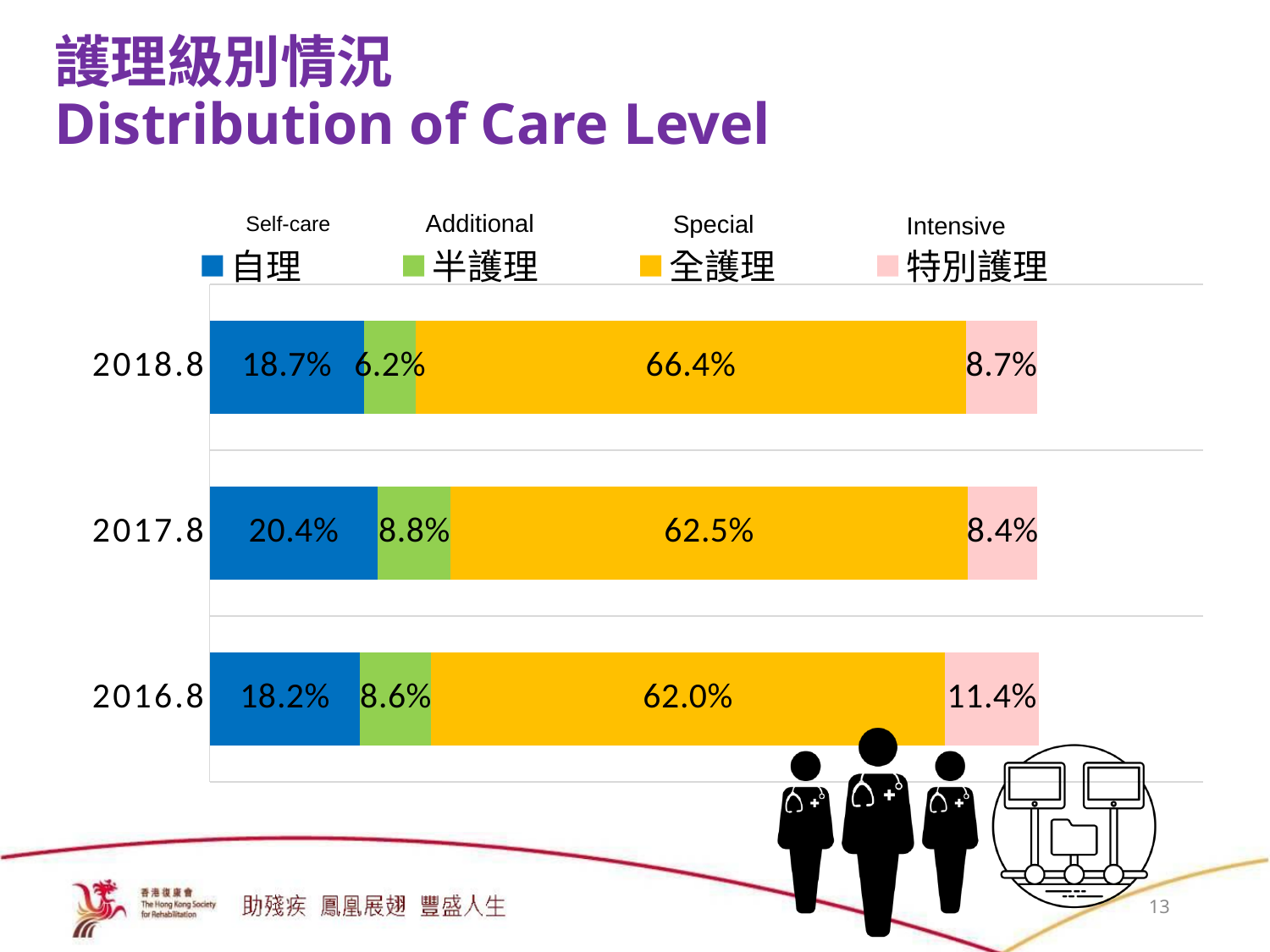
What is the difference between the Self-care (自理) shares for 2017.8 and 2016.8? 2.2% What is the Self-care (自理) share for 2017.8? 20.4% What is the Intensive (特別護理) share for 2016.8? 11.4% Which year has the highest Special (全護理) share? 2018.8 Which colour represents Special (全護理) in the chart? Yellow What kind of chart is shown on the slide? Stacked bar chart Which year has the lowest Intensive (特別護理) share? 2017.8 Which is larger: the Additional (半護理) share for 2017.8 or for 2016.8? 2017.8 How many series does the legend list? 4 What is the Additional (半護理) share for 2018.8? 6.2% What is the Special (全護理) share for 2018.8? 66.4% How many years are shown on the chart? 3